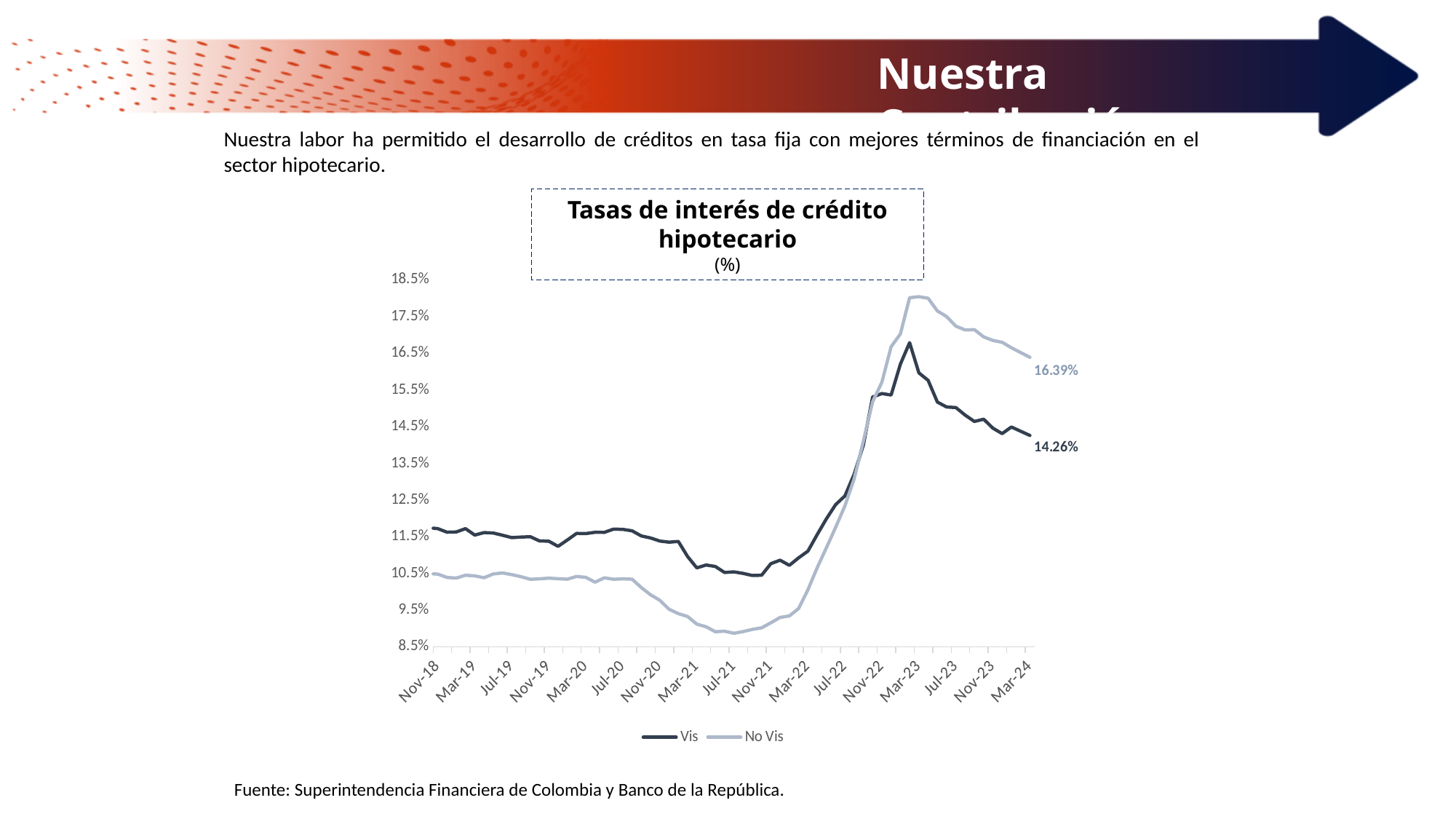
At Mar-24, which series has the higher value, Vis or No Vis? No Vis What is the title of the chart? Tasas de interés de crédito hipotecario (%) Do the values of both series rise or fall between Mar-23 and Mar-24? Fall What is the value of the Vis series at Mar-24? 14.26% Is the value of the Vis series at Nov-18 greater or less than 10.5%? greater Is the value of the No Vis series at Jul-21 greater or less than 9.5%? less Is the value of the Vis series at Mar-23 greater or less than 15.5%? greater How many series does the legend list? 2 What kind of chart is shown on the slide? Line chart What is the value of the No Vis series at Mar-24? 16.39% What is the difference between the No Vis and Vis values at Mar-24? 2.13 percentage points